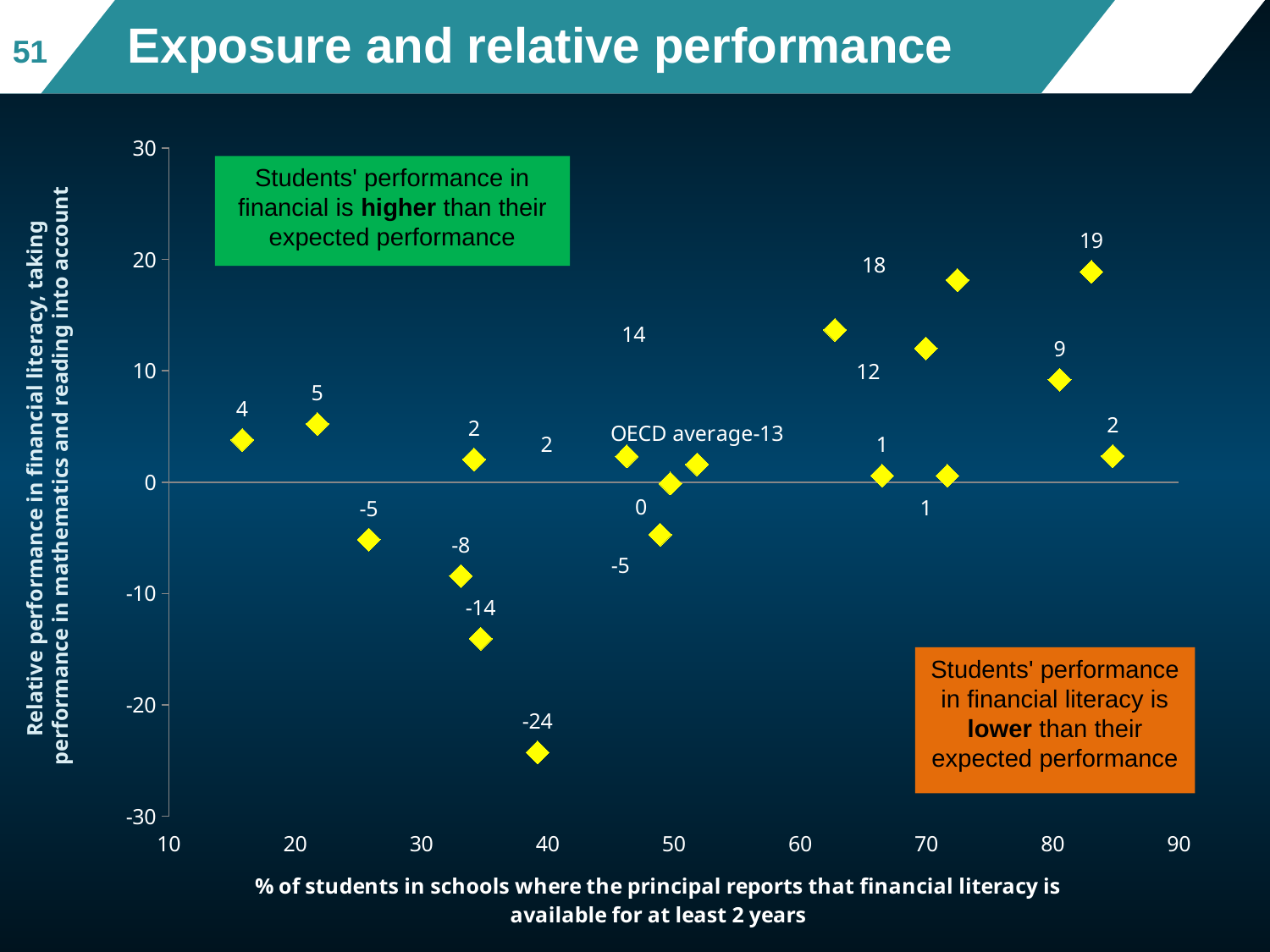
What is the lowest data-label value plotted on the chart? -24 What range does the x axis cover? 10 to 90 What is the highest data-label value plotted on the chart? 19 How many plotted points have a negative value? 5 What is the difference between the highest labeled value (19) and the lowest labeled value (-24)? 43 What kind of chart is shown on the slide? scatter chart What is the title of the x axis? % of students in schools where the principal reports that financial literacy is available for at least 2 years Do the plotted values generally rise or fall as the x-axis percentage increases? rise How many plotted points have a value above 10? 4 Is the value of the point at about 39% on the x axis greater or less than -20? less Which is larger, the point labeled 18 (near 72% on the x axis) or the point labeled 14 (near 63% on the x axis)? 18 Is the value of the point at about 83% on the x axis greater or less than 10? greater